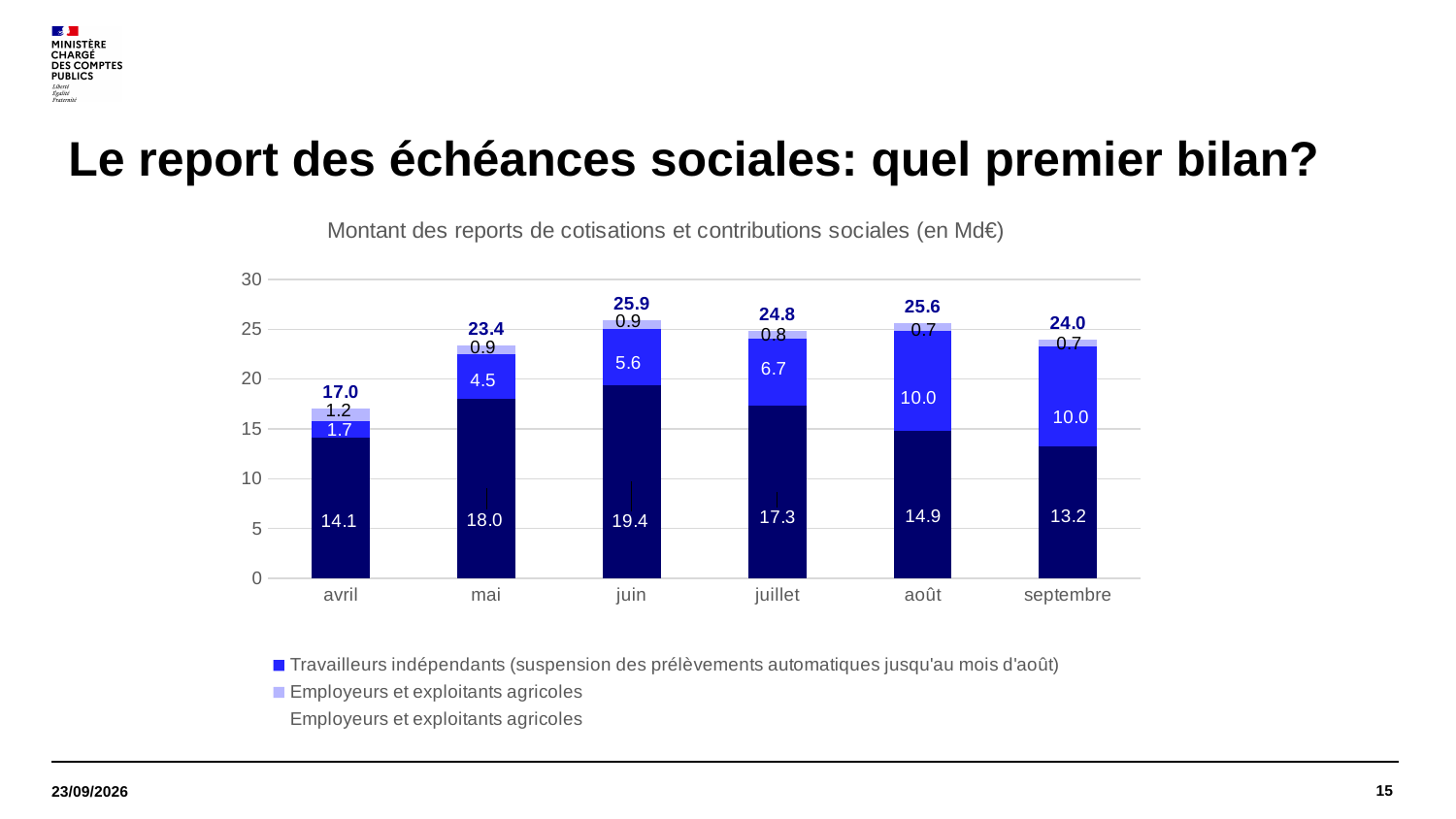
Is the value for Travailleurs indépendants larger in juillet or in mai? juillet Which month has the highest total amount of reports? juin Which month has the lowest total amount of reports? avril What kind of chart is shown on the slide? Stacked bar chart Is the total for mai greater or less than 20? greater What is the total amount shown above the bar for juin? 25.9 What is the title of the chart? Montant des reports de cotisations et contributions sociales (en Md€) Does the value for Travailleurs indépendants rise or fall from avril to août? Rises What is the value for Travailleurs indépendants in août? 10.0 How many months are shown on the x axis of the chart? 6 What is the value of the dark navy bottom segment for juin? 19.4 What is the difference between the total for juin and the total for avril? 8.9